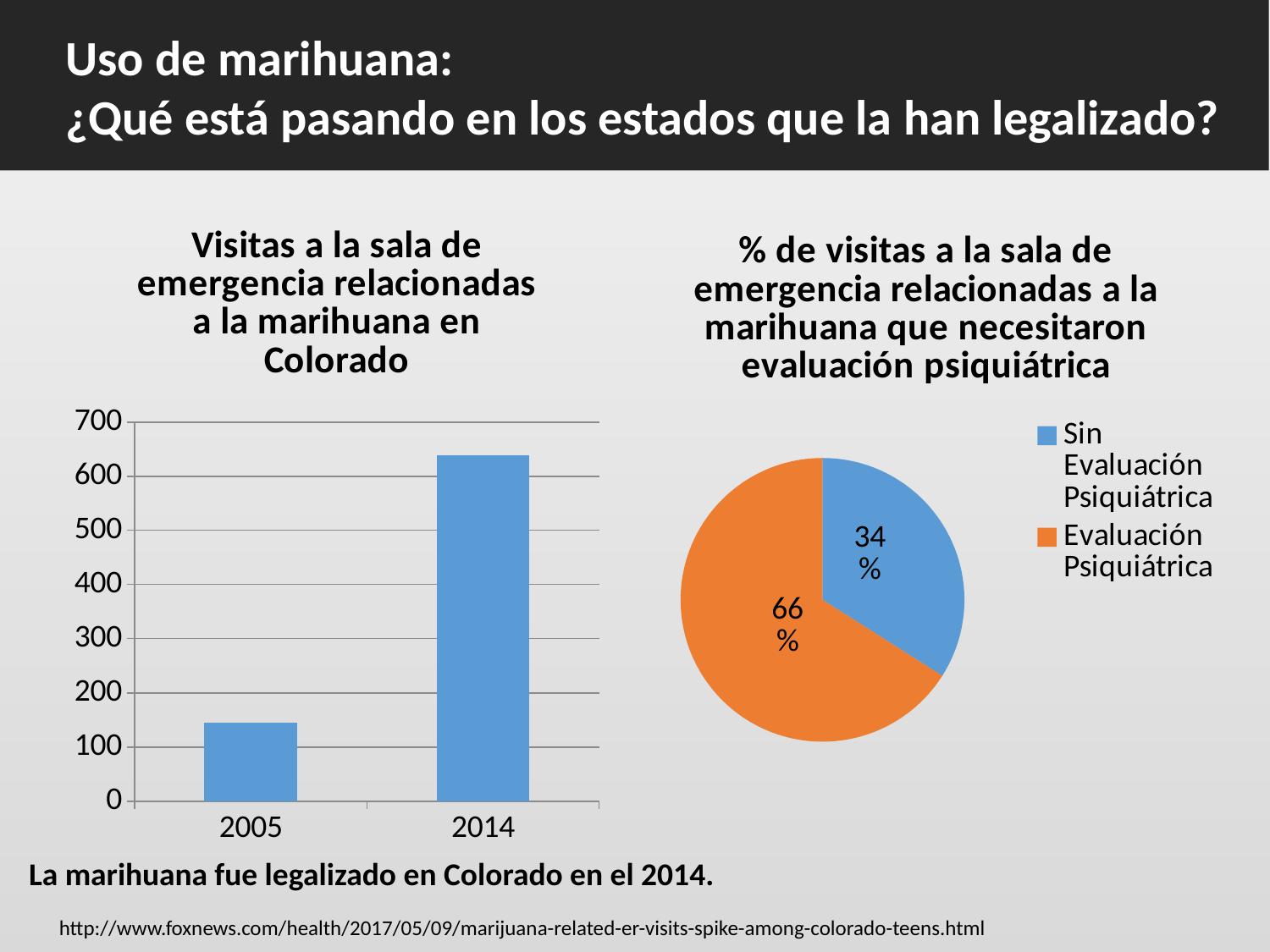
In the left bar chart, which year has the lower number of emergency room visits? 2005 What kind of chart is the left chart, 'Visitas a la sala de emergencia relacionadas a la marihuana en Colorado'? bar chart In the left bar chart, is the value for 2014 greater or less than 600? greater What kind of chart is the right chart, '% de visitas a la sala de emergencia relacionadas a la marihuana que necesitaron evaluación psiquiátrica'? pie chart In the right pie chart, what share of visits required 'Evaluación Psiquiátrica'? 66% In the left bar chart, is the value for 2005 greater or less than 200? less In the left bar chart, how many years are shown on the x axis? 2 In the left bar chart, do the values rise or fall from 2005 to 2014? rise In the left bar chart, which year has the higher number of emergency room visits? 2014 In the right pie chart, what colour is the 'Evaluación Psiquiátrica' slice? orange In the right pie chart, how many entries does the legend list? 2 In the right pie chart, what share of visits is labelled 'Sin Evaluación Psiquiátrica'? 34%